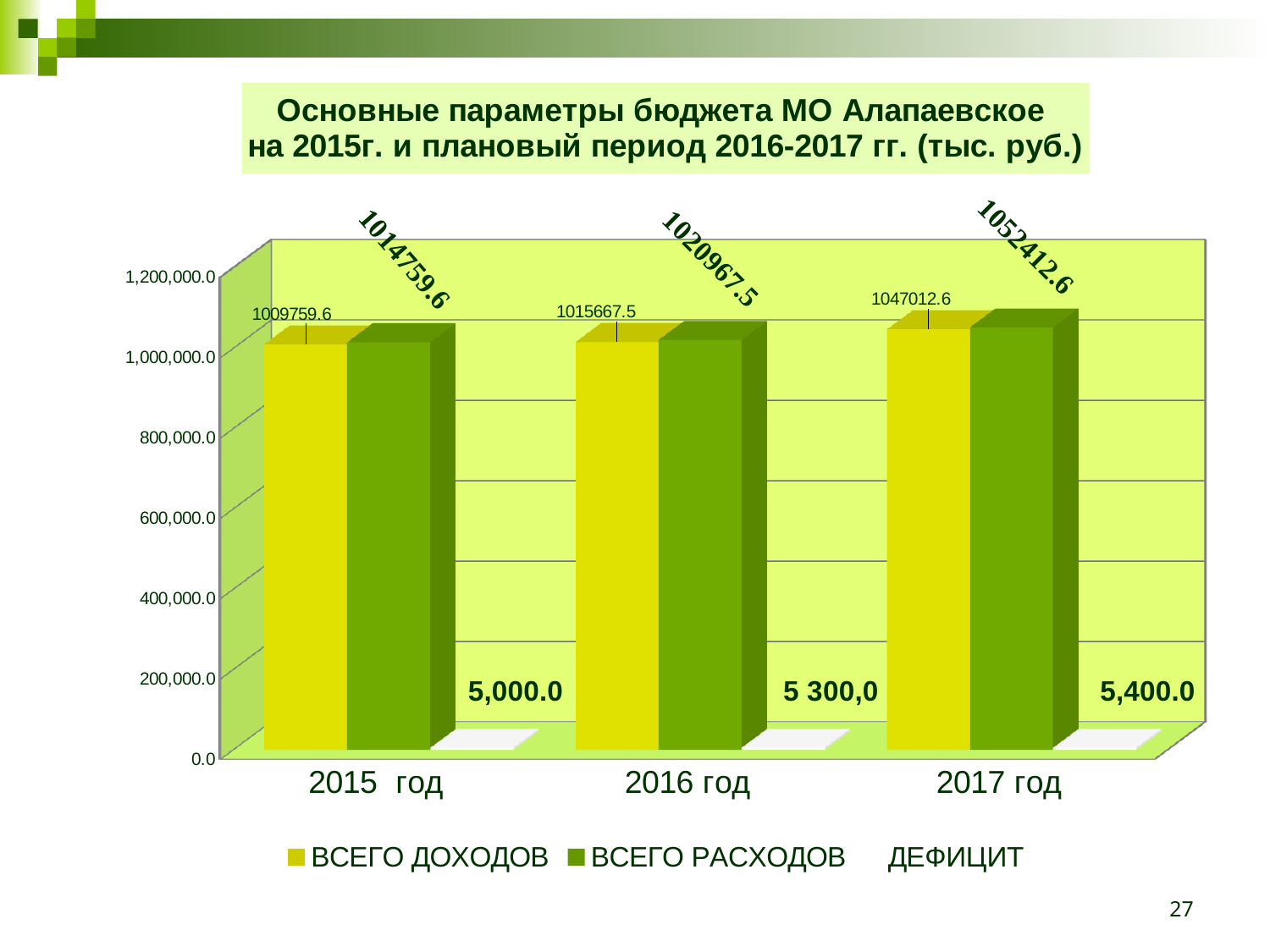
By how much does ВСЕГО ДОХОДОВ in 2017 год exceed ВСЕГО ДОХОДОВ in 2015 год? 37253.0 What is the value of ВСЕГО РАСХОДОВ for 2016 год? 1020967.5 What is the value of ДЕФИЦИТ for 2017 год? 5,400.0 Do the values of ВСЕГО ДОХОДОВ rise or fall from 2015 год to 2017 год? rise What type of chart is shown on the slide? bar chart What is the value of ВСЕГО ДОХОДОВ for 2015 год? 1009759.6 What is the difference between ВСЕГО РАСХОДОВ and ВСЕГО ДОХОДОВ in 2015 год? 5000.0 How many series does the legend list? 3 In which year is ВСЕГО ДОХОДОВ the lowest? 2015 год What is the value of ВСЕГО ДОХОДОВ for 2017 год? 1047012.6 Which is larger in 2016 год: ВСЕГО ДОХОДОВ or ВСЕГО РАСХОДОВ? ВСЕГО РАСХОДОВ In which year is ВСЕГО РАСХОДОВ the highest? 2017 год